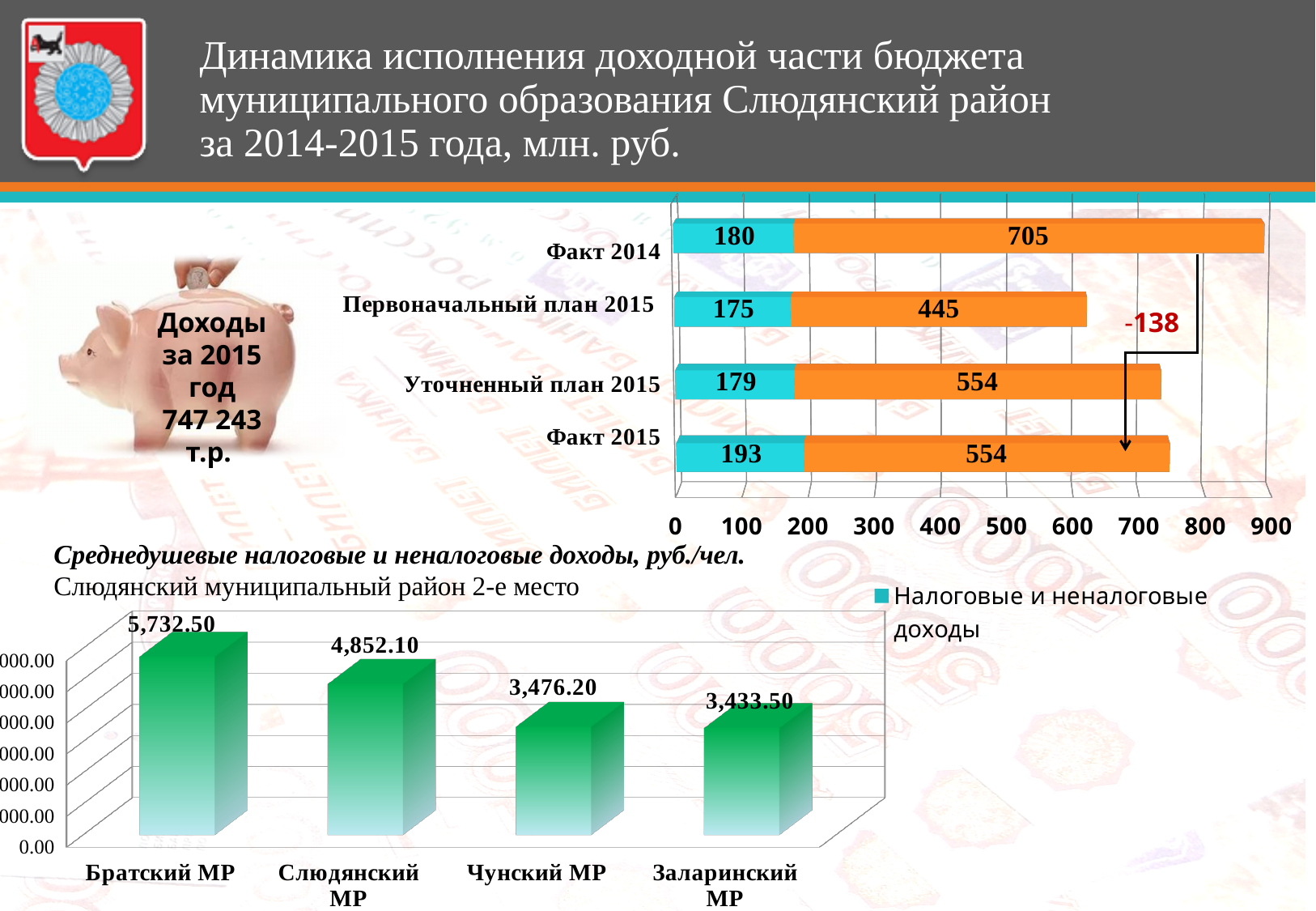
In the bottom chart (Среднедушевые налоговые и неналоговые доходы), what is the difference between Братский МР and Чунский МР? 2,256.30 In the top chart, what is the value of the orange segment for Факт 2014? 705 In the top chart, what is the difference between the orange segment values for Факт 2014 and Уточненный план 2015? 151 In the bottom chart (Среднедушевые налоговые и неналоговые доходы), do the values rise or fall from left to right? fall In the top chart, what is the total of the stacked bar for Факт 2015? 747 In the top chart, what is the value of the cyan segment for Факт 2015? 193 In the top chart, how many categories are shown? 4 In the bottom chart (Среднедушевые налоговые и неналоговые доходы), what is the value for Слюдянский МР? 4,852.10 In the top chart, which category has the longest total bar? Факт 2014 In the bottom chart (Среднедушевые налоговые и неналоговые доходы), which category has the lowest value? Заларинский МР In the top chart, what is the total of the stacked bar for Первоначальный план 2015? 620 In the bottom chart (Среднедушевые налоговые и неналоговые доходы), how many series does the legend list? 1